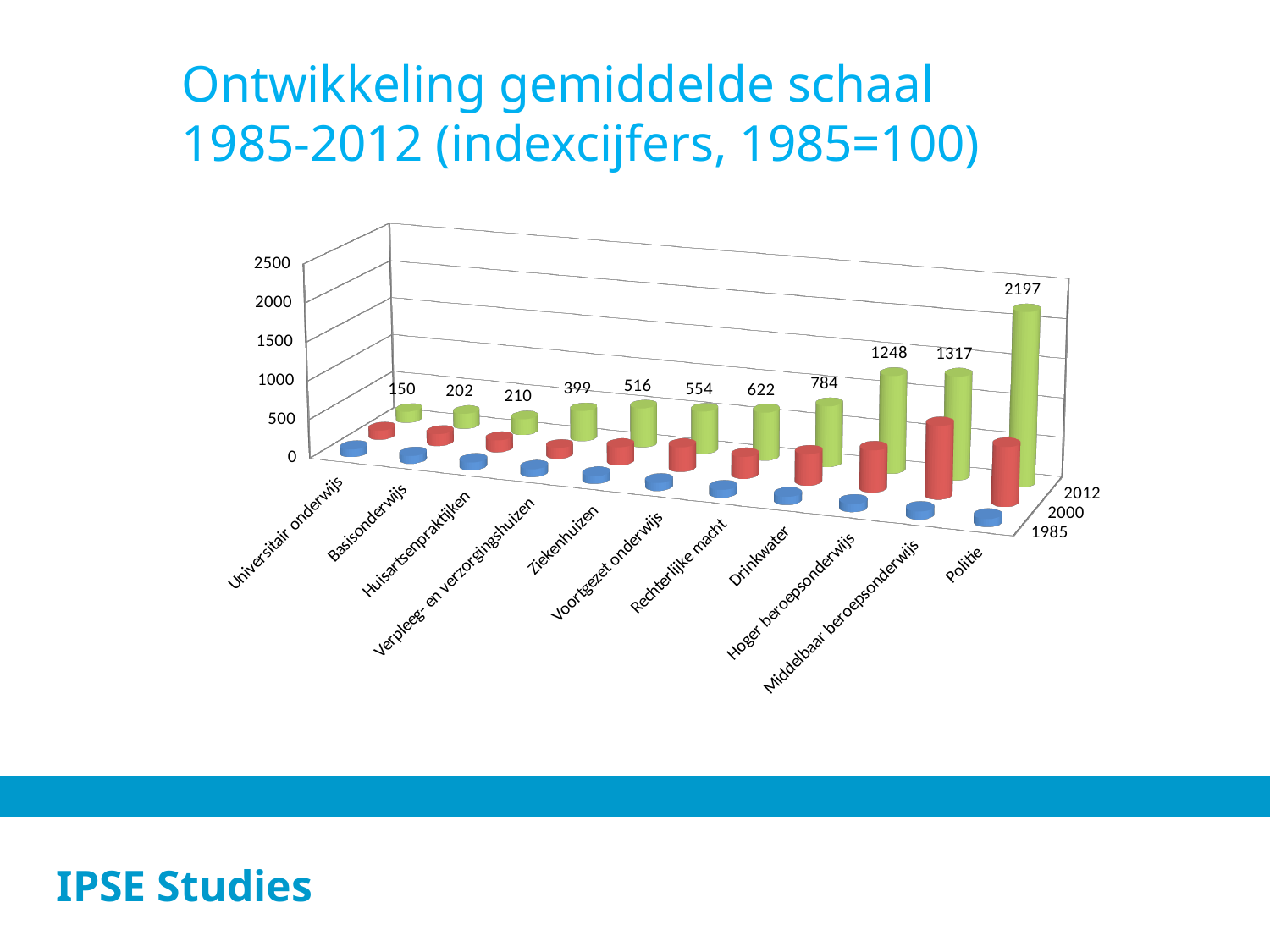
Which has a larger 2012 index value, Drinkwater or Rechterlijke macht? Drinkwater Do the 2012 index values rise or fall from left to right along the x axis? rise What is the 2012 index value for Ziekenhuizen? 516 Which category has the highest 2012 index value? Politie Which category has the lowest 2012 index value? Universitair onderwijs How many categories are shown on the x axis? 11 How many series (years) does the chart show? 3 What is the 2012 index value for Hoger beroepsonderwijs? 1248 What kind of chart is shown on the slide? bar chart What is the 2012 index value for Politie? 2197 What is the difference between the 2012 index values for Politie and Middelbaar beroepsonderwijs? 880 Is the 2012 index value for Politie greater or less than 2000? greater